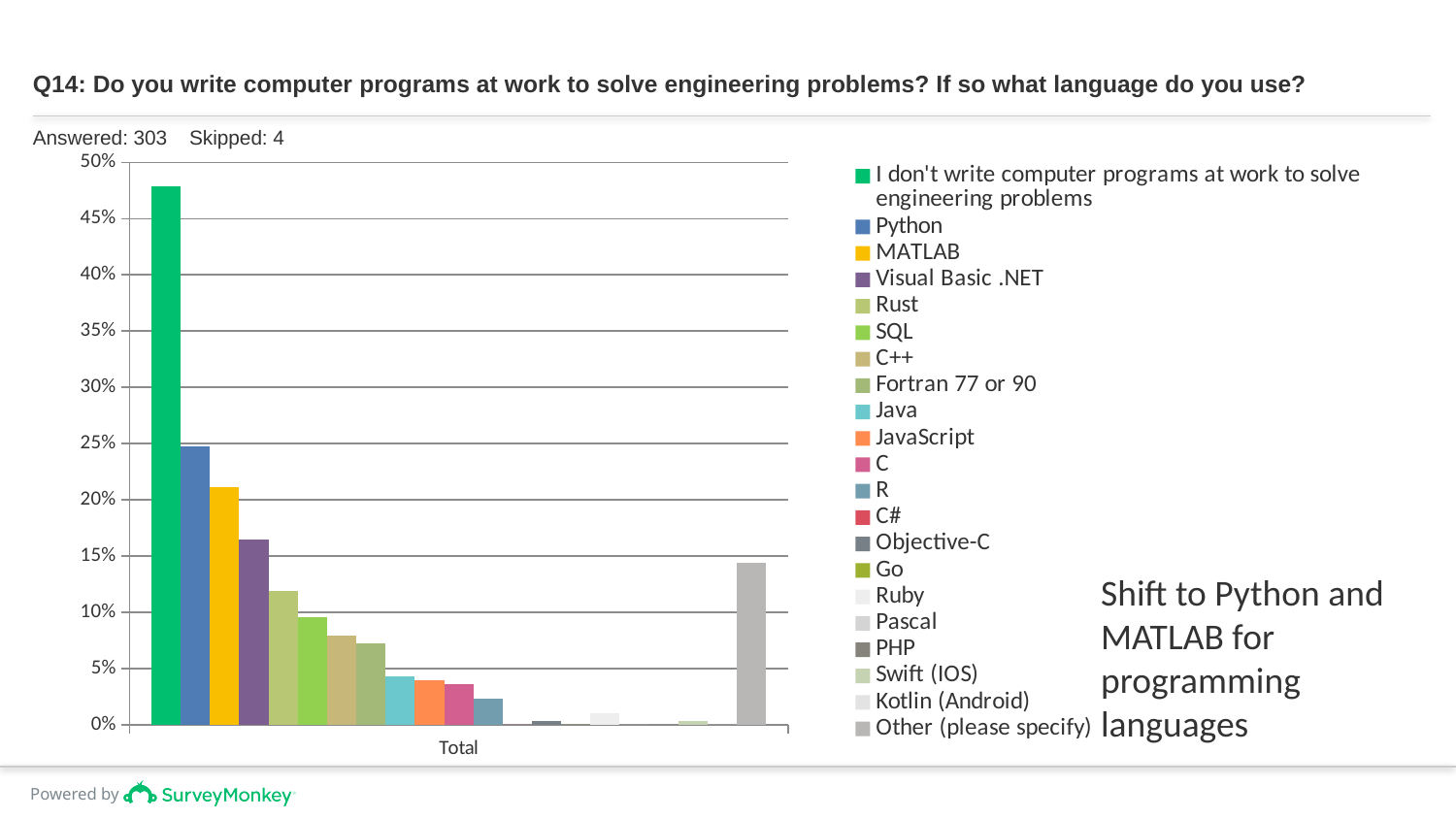
How many series does the legend list? 21 Is the value for MATLAB greater or less than 25%? less What kind of chart is shown on the slide? bar chart Which is larger, the value for Rust or the value for Other (please specify)? Other (please specify) Which is larger, the value for Python or the value for MATLAB? Python Is the value for Python greater or less than 20%? greater Which series has the highest value in the chart? I don't write computer programs at work to solve engineering problems Is the value for Rust greater or less than 10%? greater How many respondents answered the question according to the slide? 303